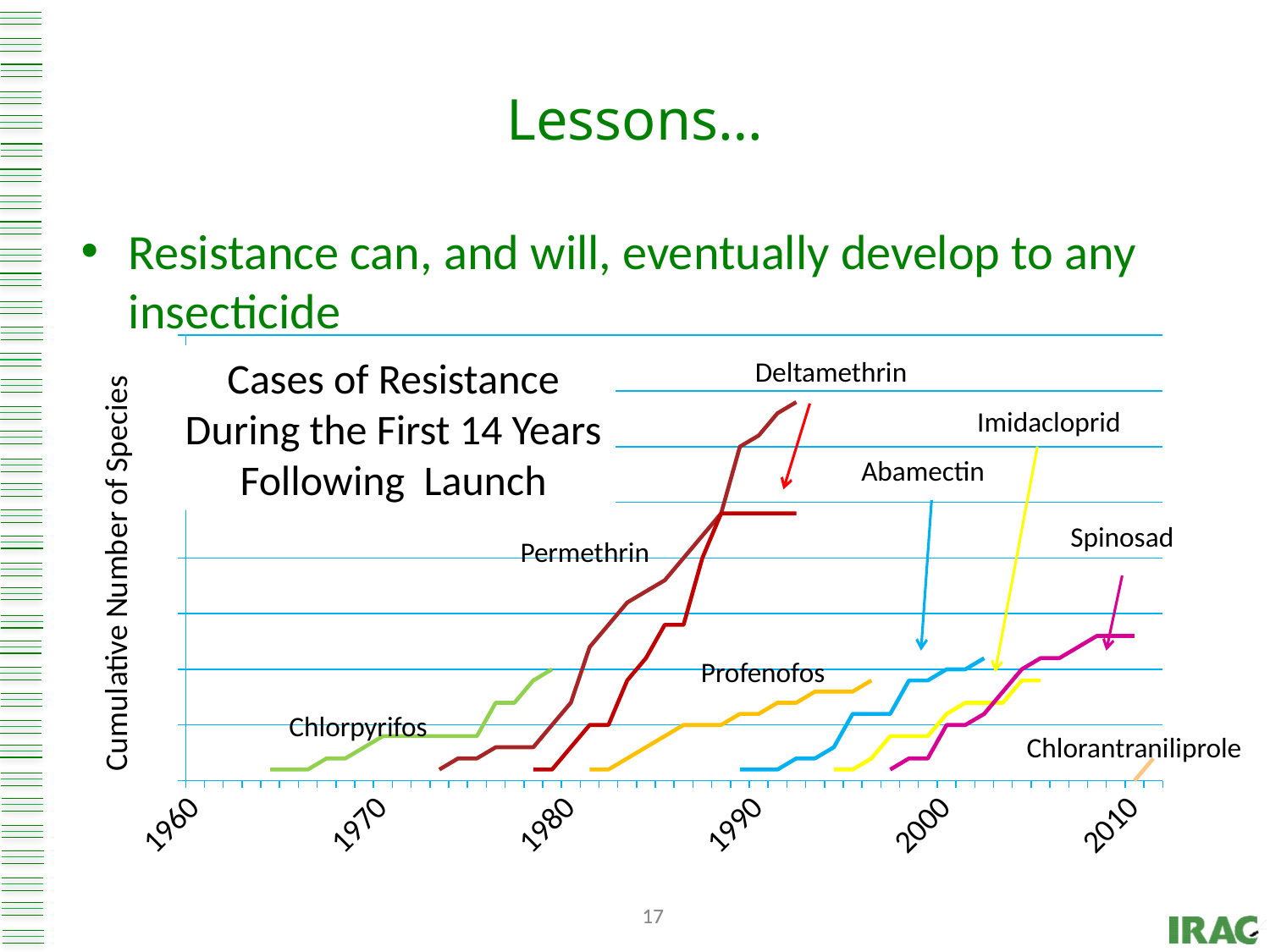
Which insecticide's line reaches the lowest cumulative number of species on the chart? Chlorantraniliprole Which line reaches a higher cumulative number of species, Deltamethrin or Profenofos? Deltamethrin What is the label on the vertical axis of the chart? Cumulative Number of Species What is the title of the chart? Cases of Resistance During the First 14 Years Following Launch Do the lines on the chart rise or fall as the years increase? rise Which line reaches a higher cumulative number of species, Permethrin or Chlorpyrifos? Permethrin Which line reaches a higher cumulative number of species, Spinosad or Imidacloprid? Spinosad Which insecticide's line starts earliest on the horizontal axis? Chlorpyrifos Which insecticide's line reaches the highest cumulative number of species on the chart? Permethrin How many year labels are shown on the horizontal axis? 6 How many insecticides are plotted as lines on the chart? 8 What kind of chart is shown on the slide? line chart